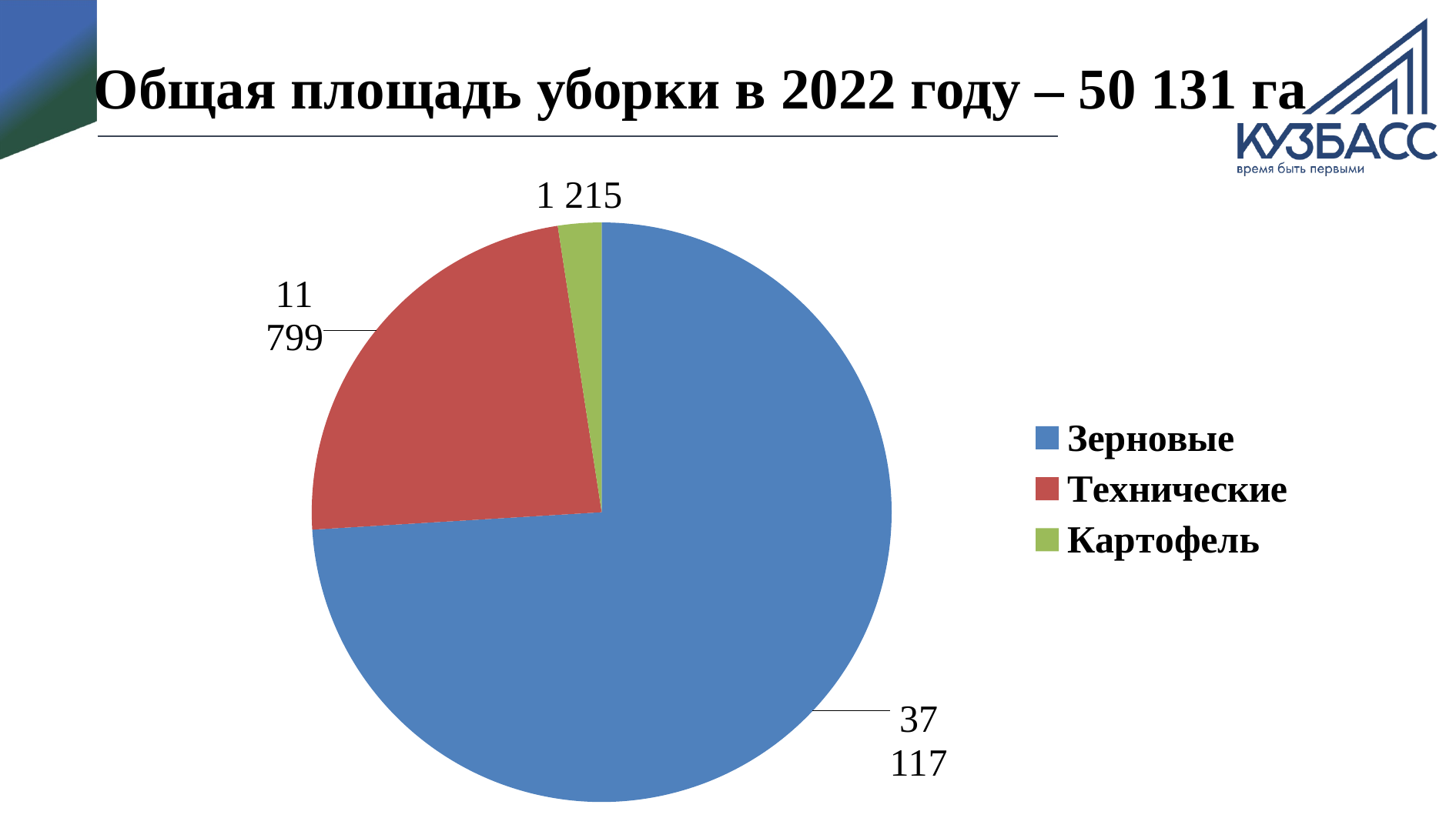
What is the difference between the values for Зерновые and Технические? 25 318 Which category has the smallest slice of the pie? Картофель What is the value for Зерновые? 37 117 What is the value for Технические? 11 799 What is the total of all slices in the pie chart? 50 131 What is the difference between the values for Технические and Картофель? 10 584 Which colour represents Технические in the pie chart? red Which category has the largest slice of the pie? Зерновые What type of chart is shown on the slide? pie chart How many categories does the pie chart have? 3 What is the value for Картофель? 1 215 Which is larger, the value for Технические or the value for Картофель? Технические